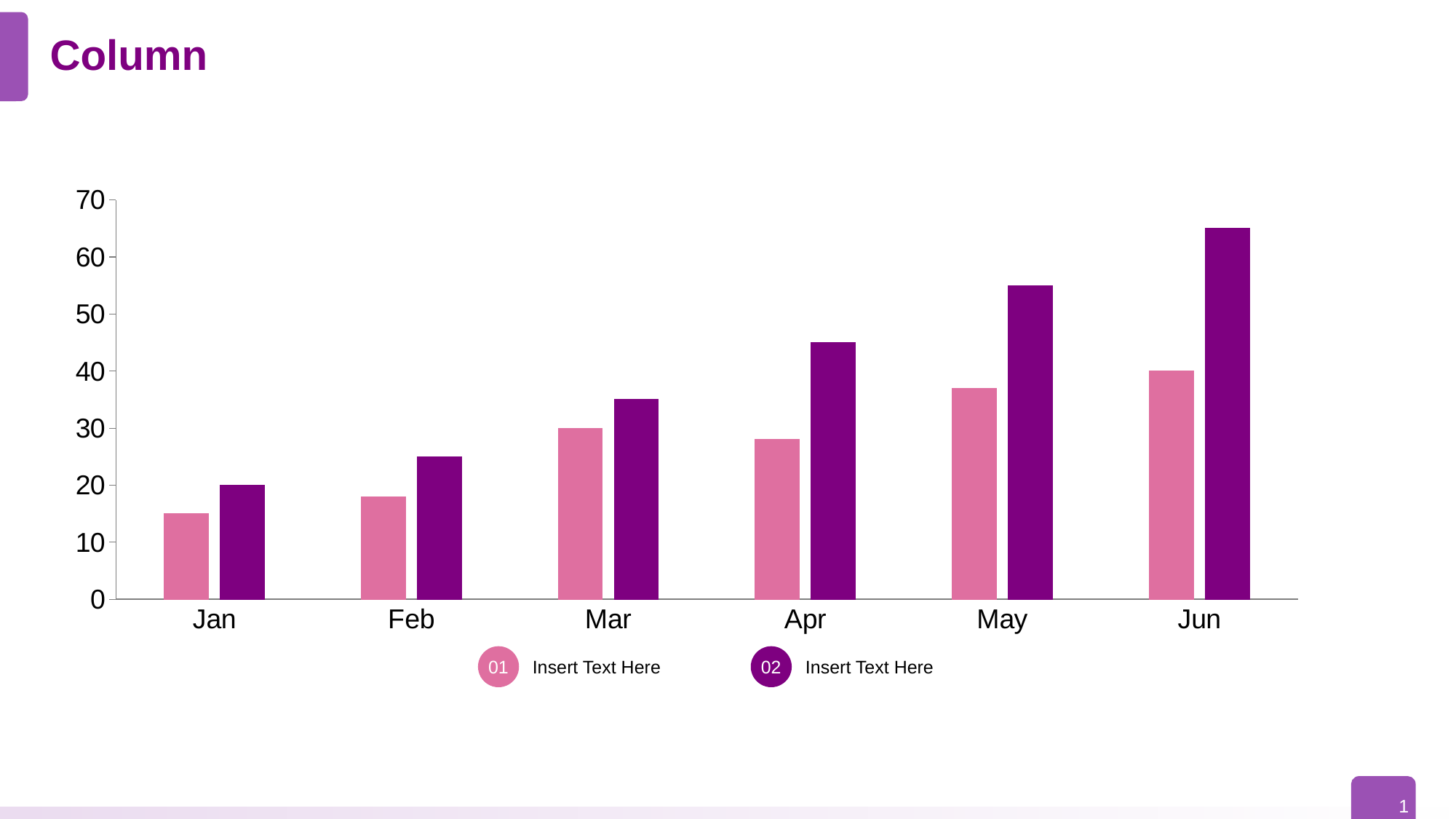
What is the value of the dark purple (02) bar for Jan? 20 What is the value of the pink (01) bar for Mar? 30 Is the pink (01) value for Jan greater or less than 20? less Which is larger for Apr, the pink (01) bar or the dark purple (02) bar? dark purple (02) Is the dark purple (02) value for Jun greater or less than 60? greater How many series does the legend list? 2 Which month has the highest dark purple (02) bar? Jun What type of chart is shown on the slide? bar chart What is the value of the pink (01) bar for Jun? 40 Do the dark purple (02) values rise or fall from Jan to Jun? rise Which month has the lowest pink (01) bar? Jan How many months are shown on the x axis of the chart? 6